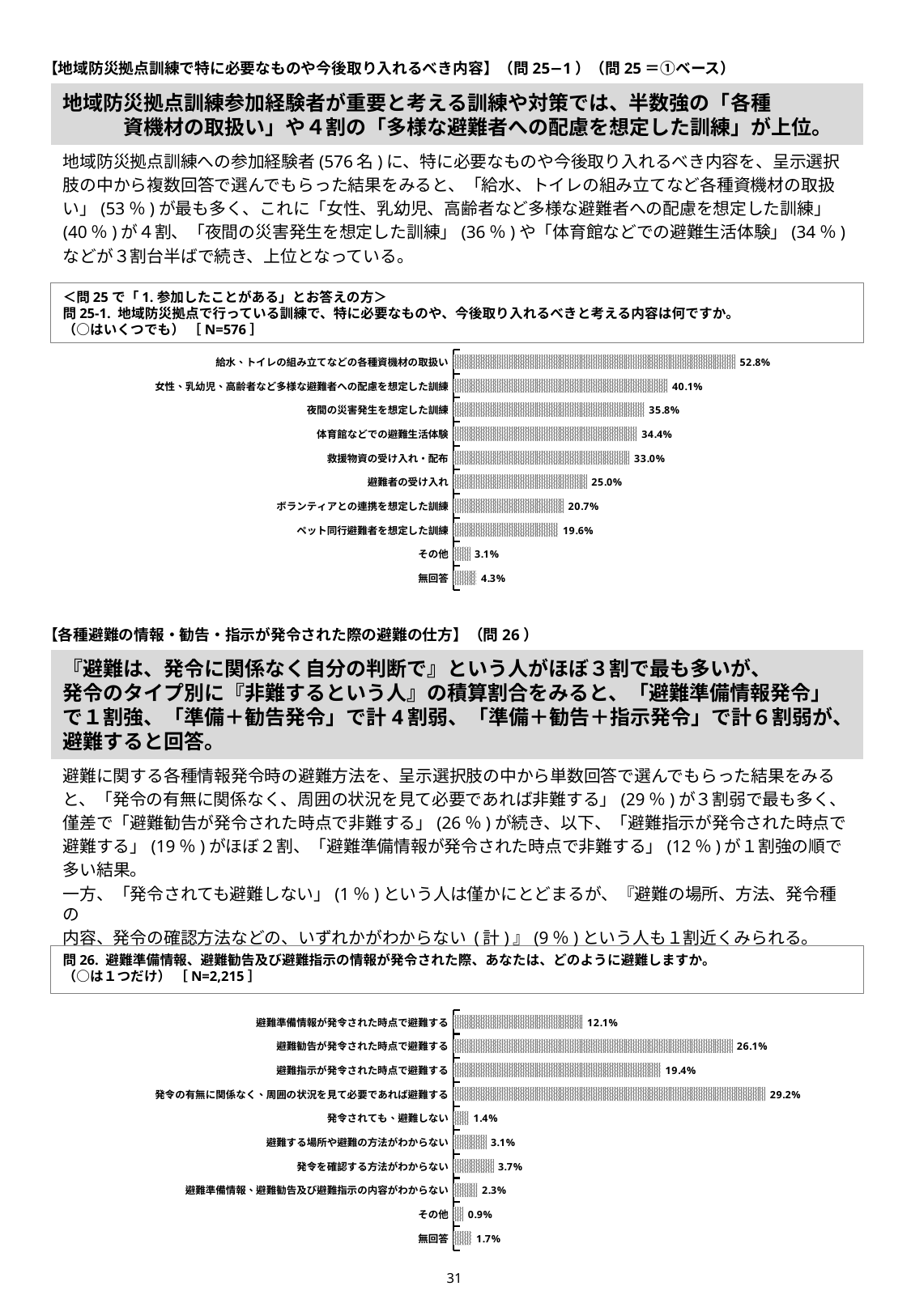
In the bottom chart (問26), what is the value for 避難勧告が発令された時点で避難する? 26.1% In the bottom chart (問26), which category has the lowest value? その他 What kind of chart is the bottom chart (問26)? Bar chart In the top chart (問25-1), which category has the highest value? 給水、トイレの組み立てなどの各種資機材の取扱い In the top chart (問25-1), what is the value for ペット同行避難者を想定した訓練? 19.6% In the top chart (問25-1), what is the value for 給水、トイレの組み立てなどの各種資機材の取扱い? 52.8% In the top chart (問25-1), how many categories are shown? 10 In the bottom chart (問26), which category has the highest value? 発令の有無に関係なく、周囲の状況を見て必要であれば避難する In the top chart (問25-1), which category has the lowest value? その他 In the bottom chart (問26), which is larger: 避難指示が発令された時点で避難する or 避難準備情報が発令された時点で避難する? 避難指示が発令された時点で避難する In the bottom chart (問26), what is the difference between 発令の有無に関係なく、周囲の状況を見て必要であれば避難する and 避難勧告が発令された時点で避難する? 3.1% In the top chart (問25-1), what is the difference between 女性、乳幼児、高齢者など多様な避難者への配慮を想定した訓練 and 夜間の災害発生を想定した訓練? 4.3%